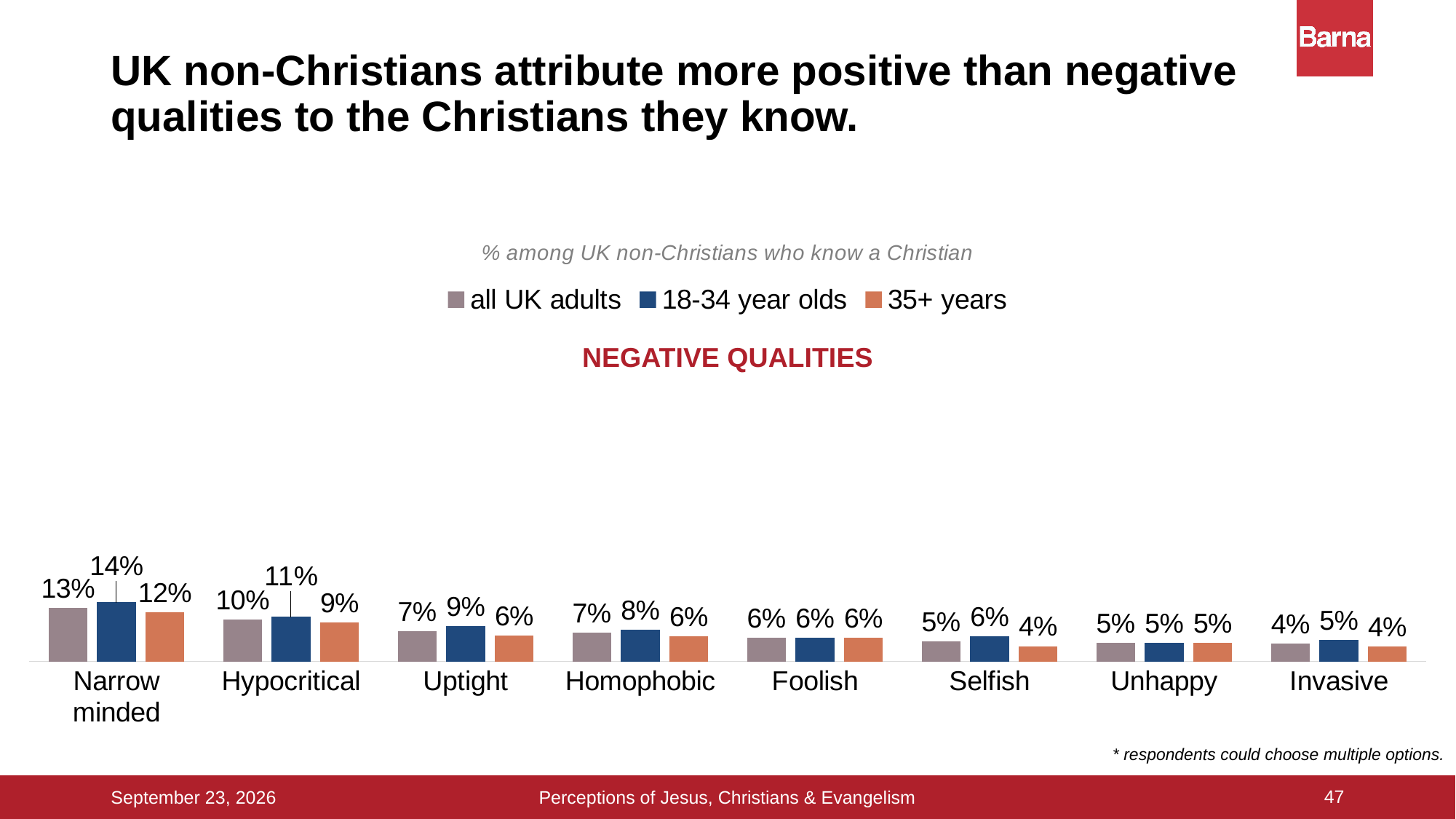
What is the difference between the 18-34 year olds and 35+ years values for 'Hypocritical'? 2% What percentage of all UK adults attribute the quality 'Narrow minded' to the Christians they know? 13% What kind of chart is shown on the slide? Bar chart How many series does the legend list? 3 Which negative quality has the lowest value among all UK adults? Invasive Which negative quality has the highest value among 18-34 year olds? Narrow minded What is the value for 35+ years for 'Uptight'? 6% What is the heading shown in red above the chart? NEGATIVE QUALITIES How many negative qualities are shown on the chart? 8 For 'Uptight', which group has the larger value: 18-34 year olds or 35+ years? 18-34 year olds What is the value for 18-34 year olds for 'Hypocritical'? 11% Do the values for all UK adults generally rise or fall from 'Narrow minded' to 'Invasive'? Fall